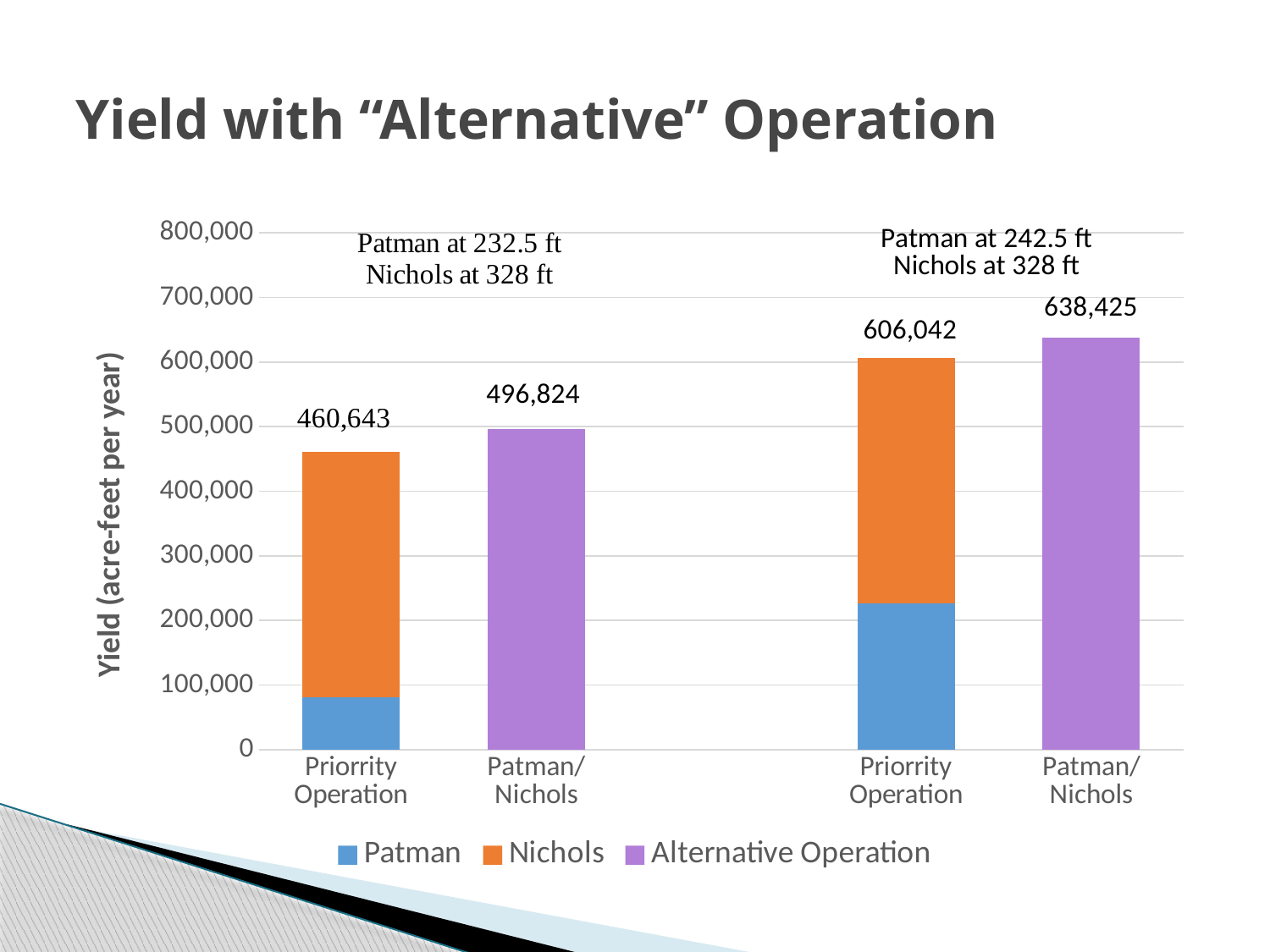
What is the total yield shown for the Priority Operation bar under the Patman at 242.5 ft / Nichols at 328 ft scenario? 606,042 Which bar has the highest yield value on the chart? Patman/Nichols (Patman at 242.5 ft, Nichols at 328 ft) What is the yield shown for the Patman/Nichols bar under the Patman at 242.5 ft / Nichols at 328 ft scenario? 638,425 What is the difference between the Patman/Nichols yield and the Priority Operation yield under the Patman at 242.5 ft scenario? 32,383 What is the difference between the Patman/Nichols yield and the Priority Operation yield under the Patman at 232.5 ft scenario? 36,181 Is the Patman portion of the Priority Operation bar under the Patman at 242.5 ft scenario greater or less than 200,000? greater Under the Patman at 232.5 ft scenario, which is larger: the Priority Operation yield or the Patman/Nichols yield? Patman/Nichols What is the total yield shown for the Priority Operation bar under the Patman at 232.5 ft / Nichols at 328 ft scenario? 460,643 What is the yield shown for the Patman/Nichols bar under the Patman at 232.5 ft / Nichols at 328 ft scenario? 496,824 What is the label of the vertical axis? Yield (acre-feet per year) How many series does the legend list? 3 Which bar has the lowest yield value on the chart? Priority Operation (Patman at 232.5 ft, Nichols at 328 ft)